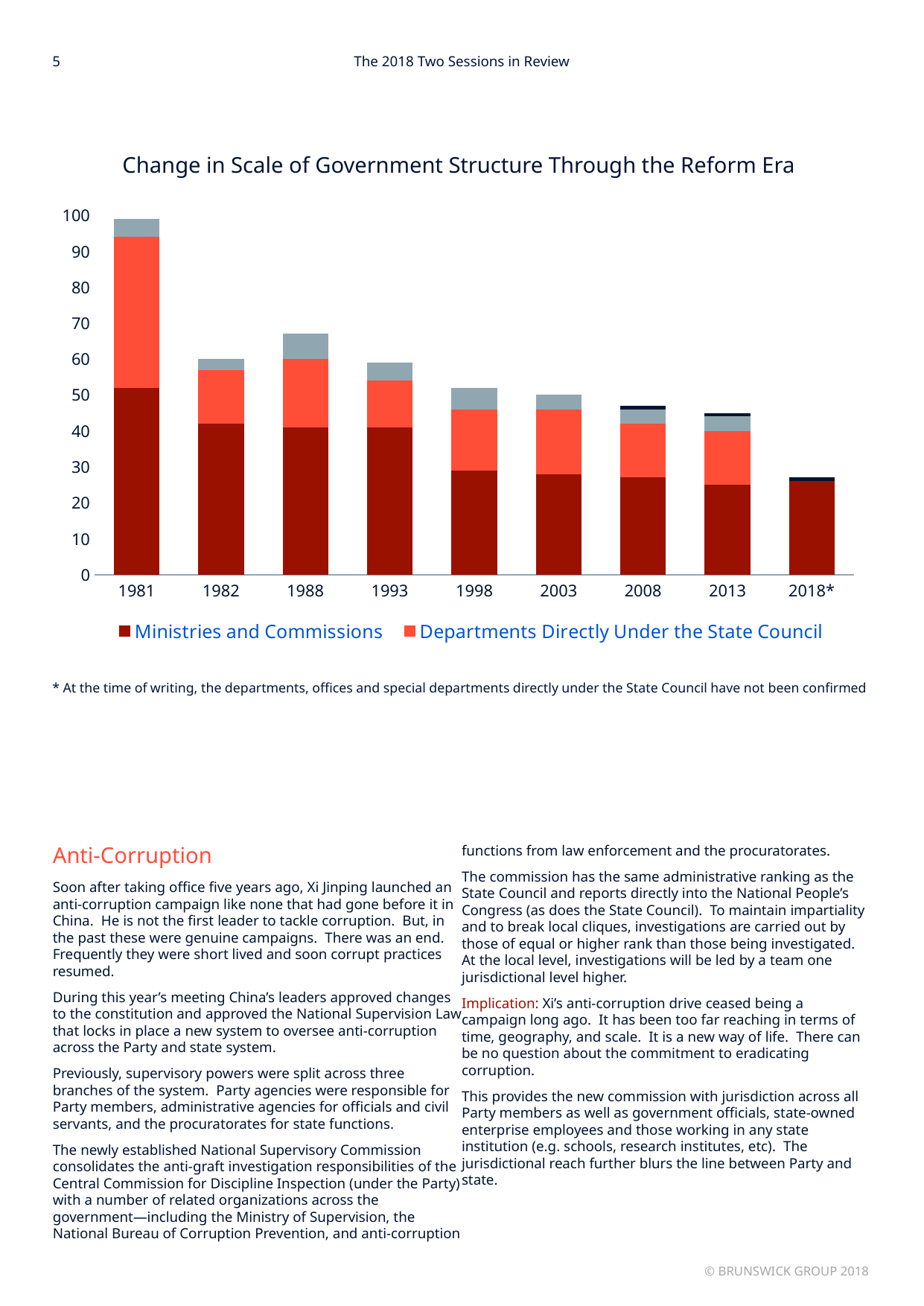
Which year has the shortest stacked bar in the chart? 2018* Which year has the larger Ministries and Commissions value, 1982 or 1998? 1982 What kind of chart is shown on the slide? Stacked bar chart Is the Ministries and Commissions value for 2013 greater or less than 30? less Is the total height of the 2018* bar greater or less than 30? less How many years are shown along the x axis of the chart? 9 Is the Ministries and Commissions value for 1981 greater or less than 50? greater Do the total bar heights generally rise or fall from 1981 to 2018*? fall Which year has the tallest stacked bar in the chart? 1981 How many series does the chart's legend list? 2 What is the title of the chart? Change in Scale of Government Structure Through the Reform Era